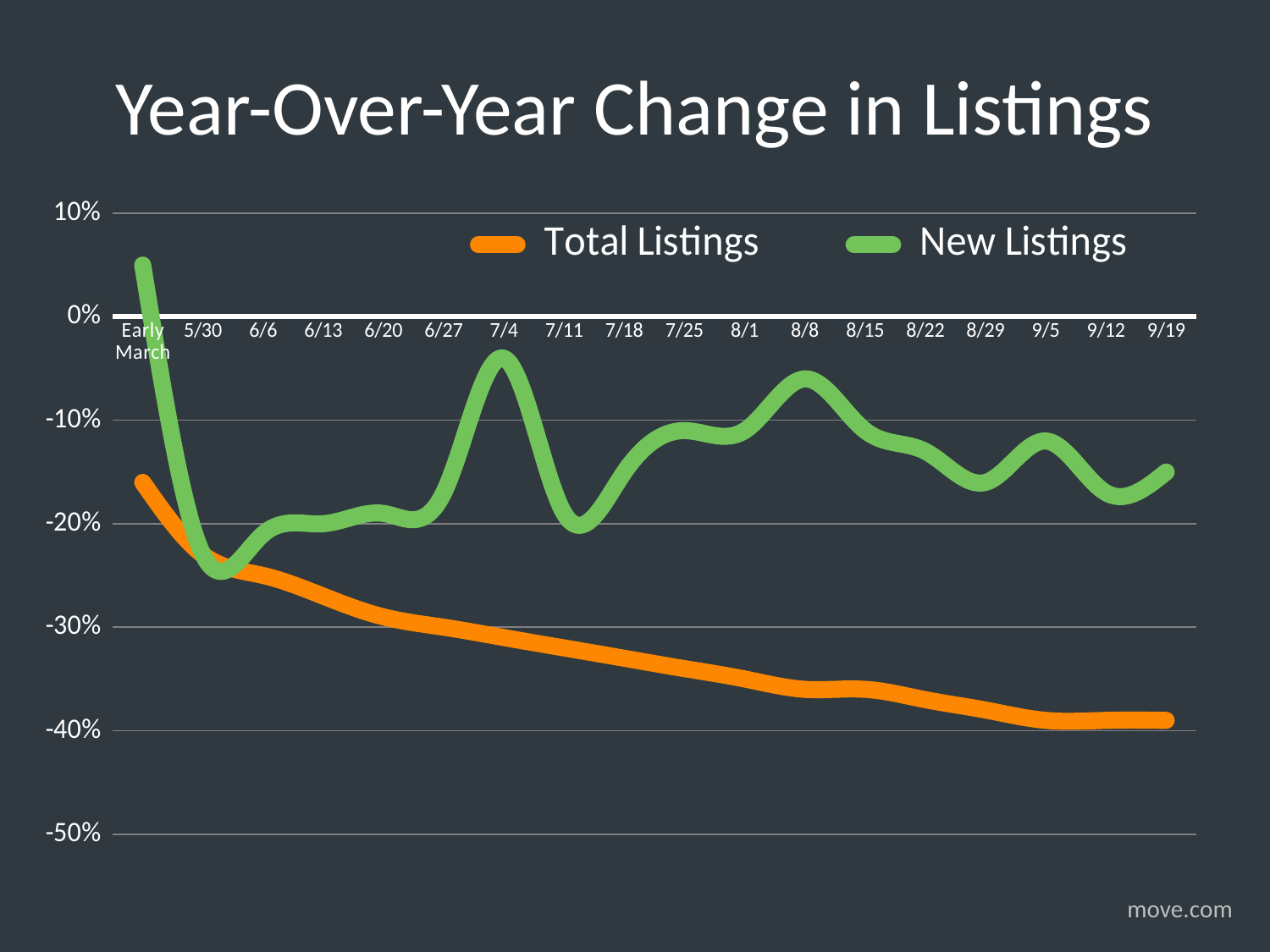
Do the Total Listings values rise or fall from Early March to 9/19? Fall What is the title of the chart? Year-Over-Year Change in Listings Is the value for New Listings at Early March greater or less than 0%? greater Is the value for New Listings at 7/4 greater or less than -10%? greater At 9/19, which series has the higher value, Total Listings or New Listings? New Listings Is the value for New Listings at 5/30 greater or less than -20%? less How many dates are labelled along the x axis? 18 Which series is drawn in green? New Listings At which date does New Listings reach its highest value? Early March How many series does the legend list? 2 What kind of chart is shown on the slide? Line chart